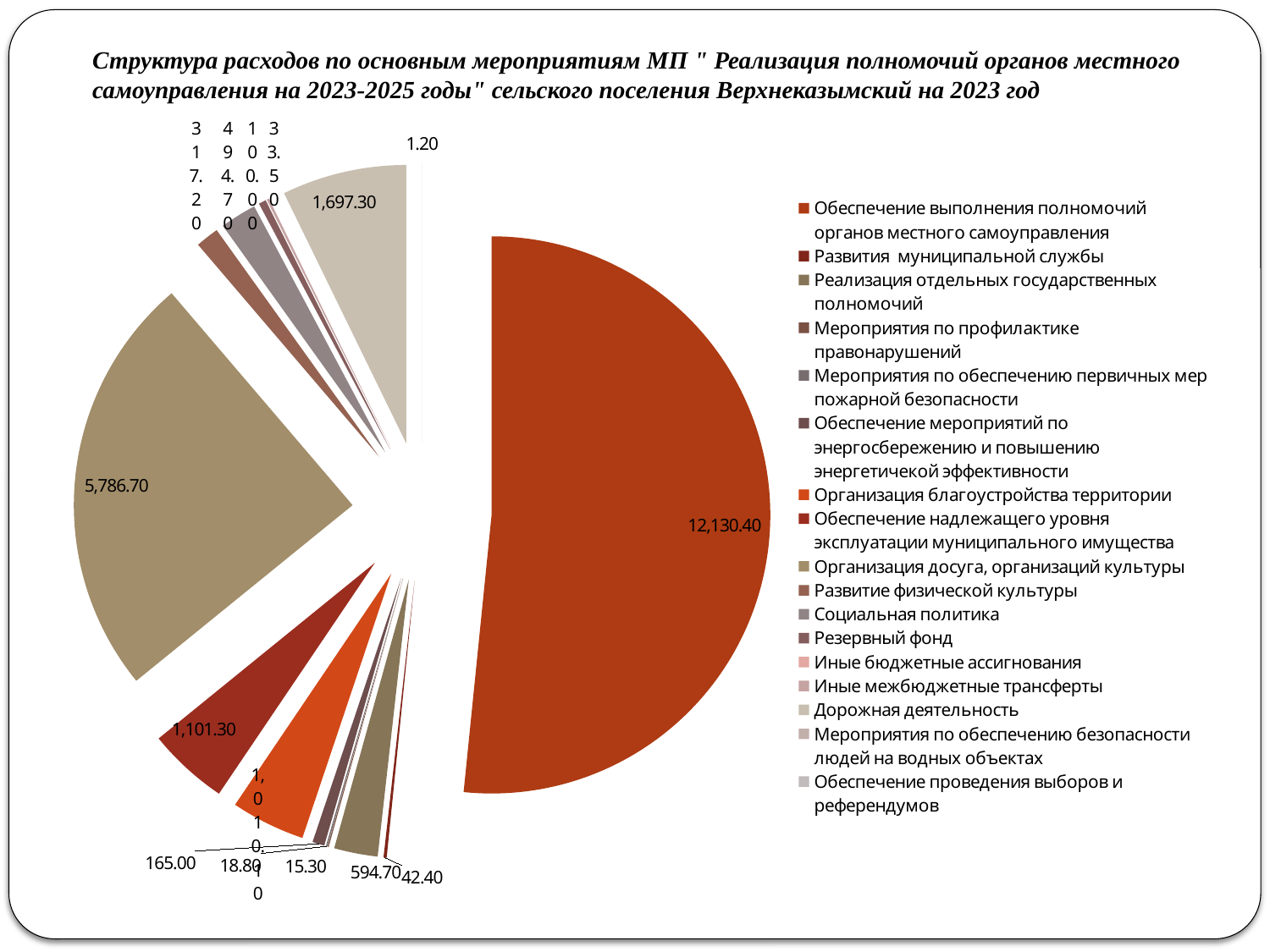
Which is larger, the slice labelled 594.70 or the slice labelled 165.00? 594.70 What is the difference between the largest slice (12,130.40) and the second-largest slice (5,786.70)? 6,343.70 What is the difference between the slices labelled 1,697.30 and 1,101.30? 596.00 Which category has the largest slice of the pie? Обеспечение выполнения полномочий органов местного самоуправления Which is larger, the slice labelled 1,101.30 or the slice labelled 1,697.30? 1,697.30 How many categories are listed in the legend? 17 What is the value of the largest slice of the pie? 12,130.40 What kind of chart is shown on the slide? pie chart What is the value of the light beige slice for Дорожная деятельность? 1,697.30 What is the value of the second-largest slice of the pie? 5,786.70 Which year does the chart title say the expenditure structure is for? 2023 What is the smallest data label shown on the pie chart? 1.20